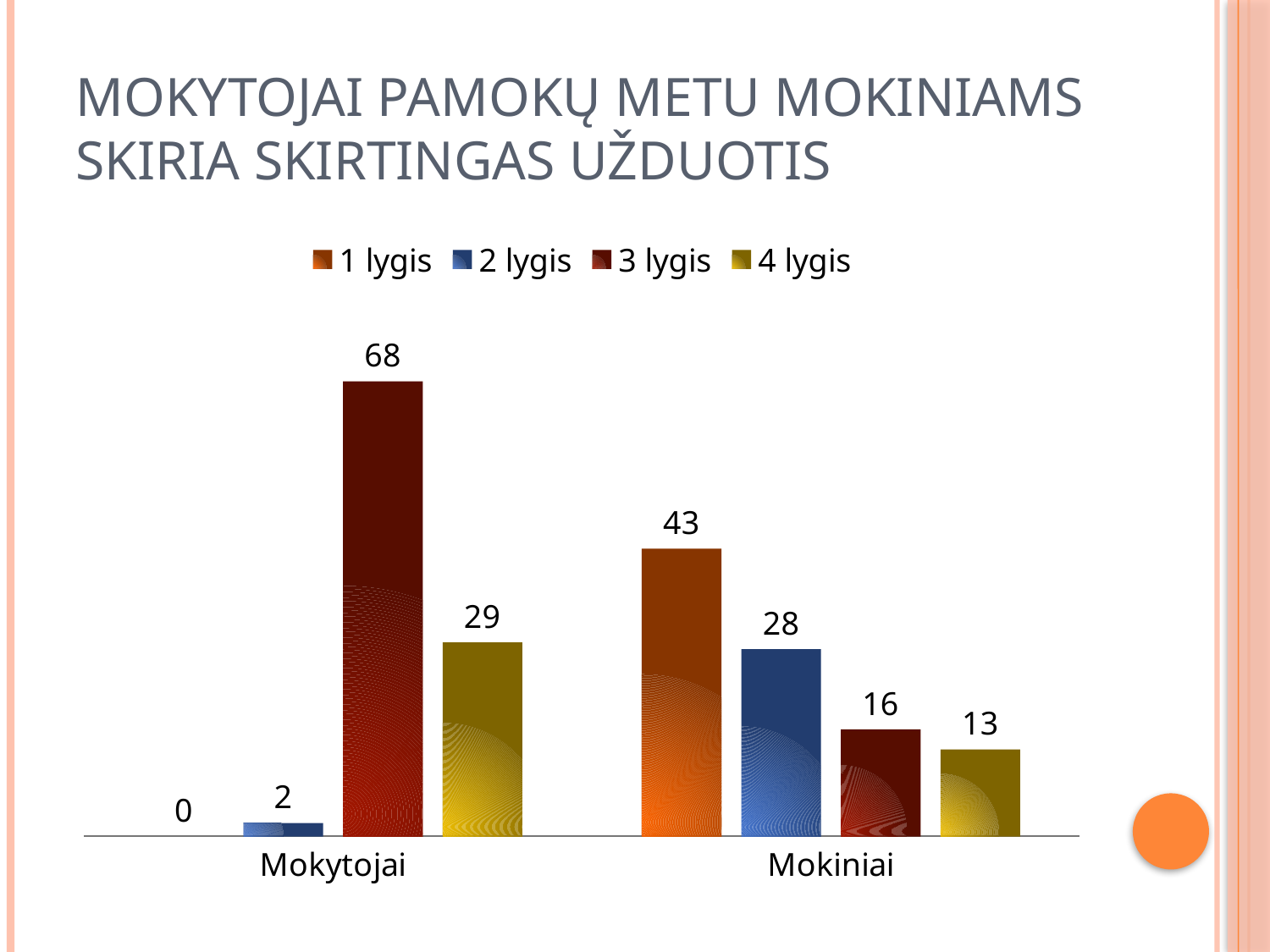
Which series has the highest value in the Mokytojai category? 3 lygis What is the value for 2 lygis in the Mokytojai category? 2 What kind of chart is shown on the slide? Bar chart Which series has the lowest value in the Mokiniai category? 4 lygis What is the value for 4 lygis in the Mokiniai category? 13 How many categories are shown on the x axis? 2 What is the value for 3 lygis in the Mokytojai category? 68 How many series does the legend list? 4 Which is larger: 4 lygis for Mokytojai or 2 lygis for Mokiniai? 4 lygis for Mokytojai What is the total of the four series values for the Mokiniai category? 100 What is the difference between the 3 lygis values for Mokytojai and Mokiniai? 52 What is the value for 1 lygis in the Mokiniai category? 43